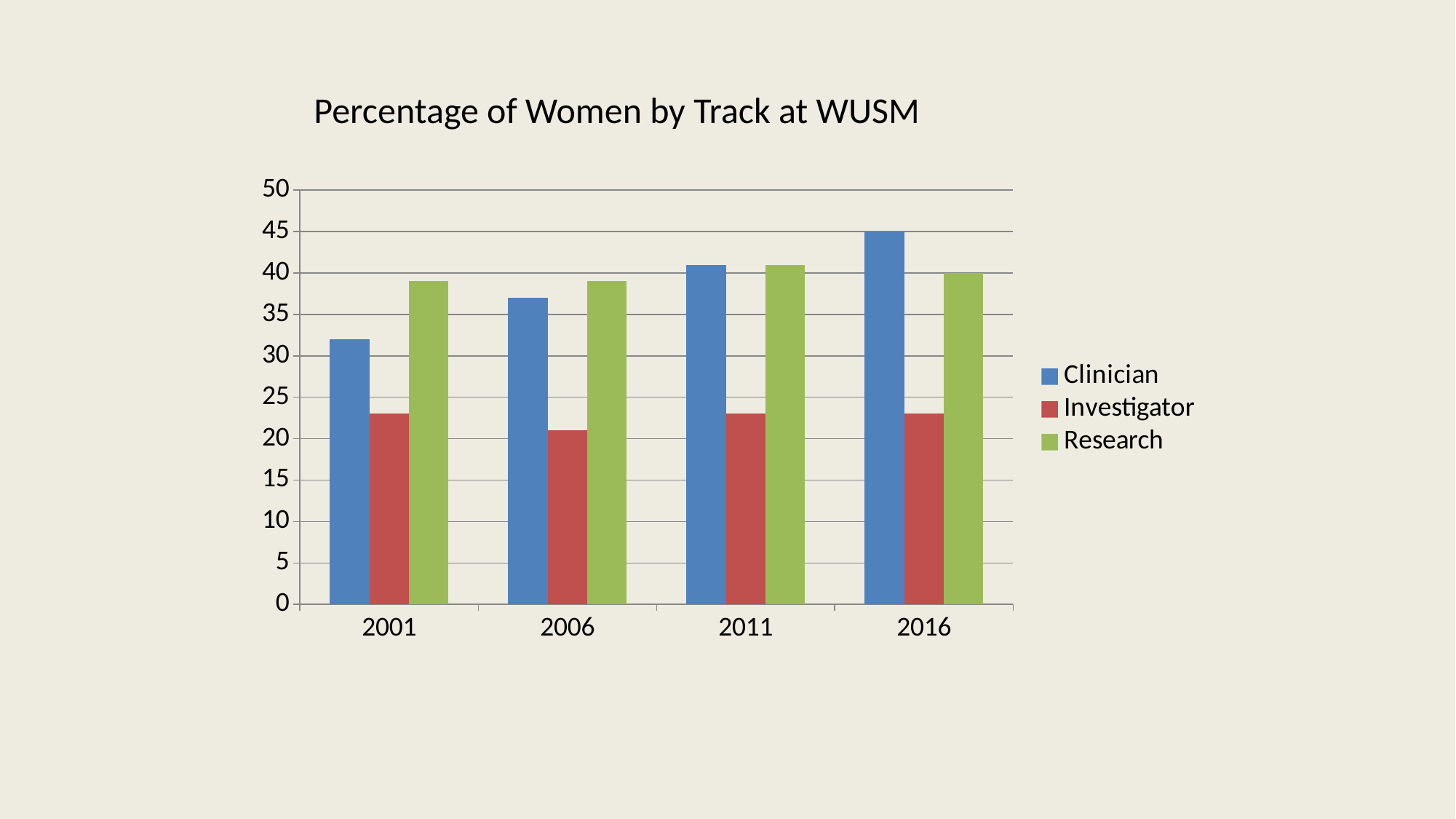
In which year is the Investigator value lowest? 2006 In 2016, which is larger, the Clinician value or the Research value? Clinician What is the Clinician value for 2016? 45 Is the Clinician value for 2001 greater or less than 35? less In which year is the Clinician value highest? 2016 In 2001, which is larger, the Clinician value or the Research value? Research What kind of chart is shown on the slide? Bar chart What is the Research value for 2016? 40 What is the title of the chart? Percentage of Women by Track at WUSM Do the Clinician values rise or fall from 2001 to 2016? rise How many years are shown on the x axis? 4 How many series does the legend list? 3